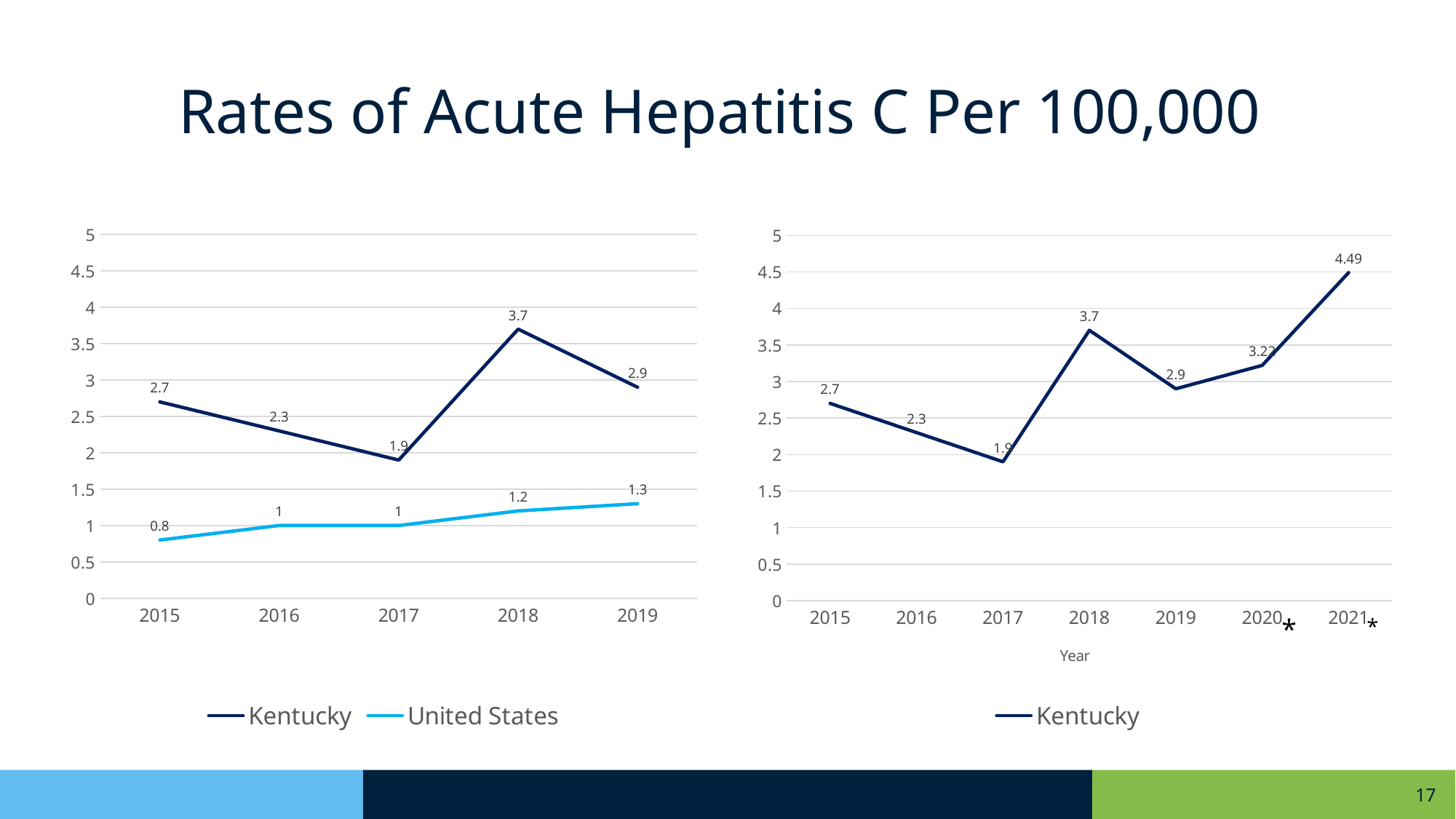
In the left chart, which is larger in 2017: the Kentucky value or the United States value? Kentucky In the right chart, what is the Kentucky value for 2020? 3.22 In the left chart, what is the United States value for 2015? 0.8 In the left chart, which year has the lowest Kentucky value? 2017 In the left chart, do the United States values rise or fall from 2015 to 2019? Rise How many years are plotted on the x axis of the right chart? 7 What kind of chart is the right chart? Line chart How many series does the legend of the left chart list? 2 In the left chart, what is the difference between the Kentucky and United States values in 2019? 1.6 In the right chart, which year has the highest Kentucky value? 2021 In the left chart, what is the Kentucky value for 2018? 3.7 In the right chart, what is the Kentucky value for 2021? 4.49